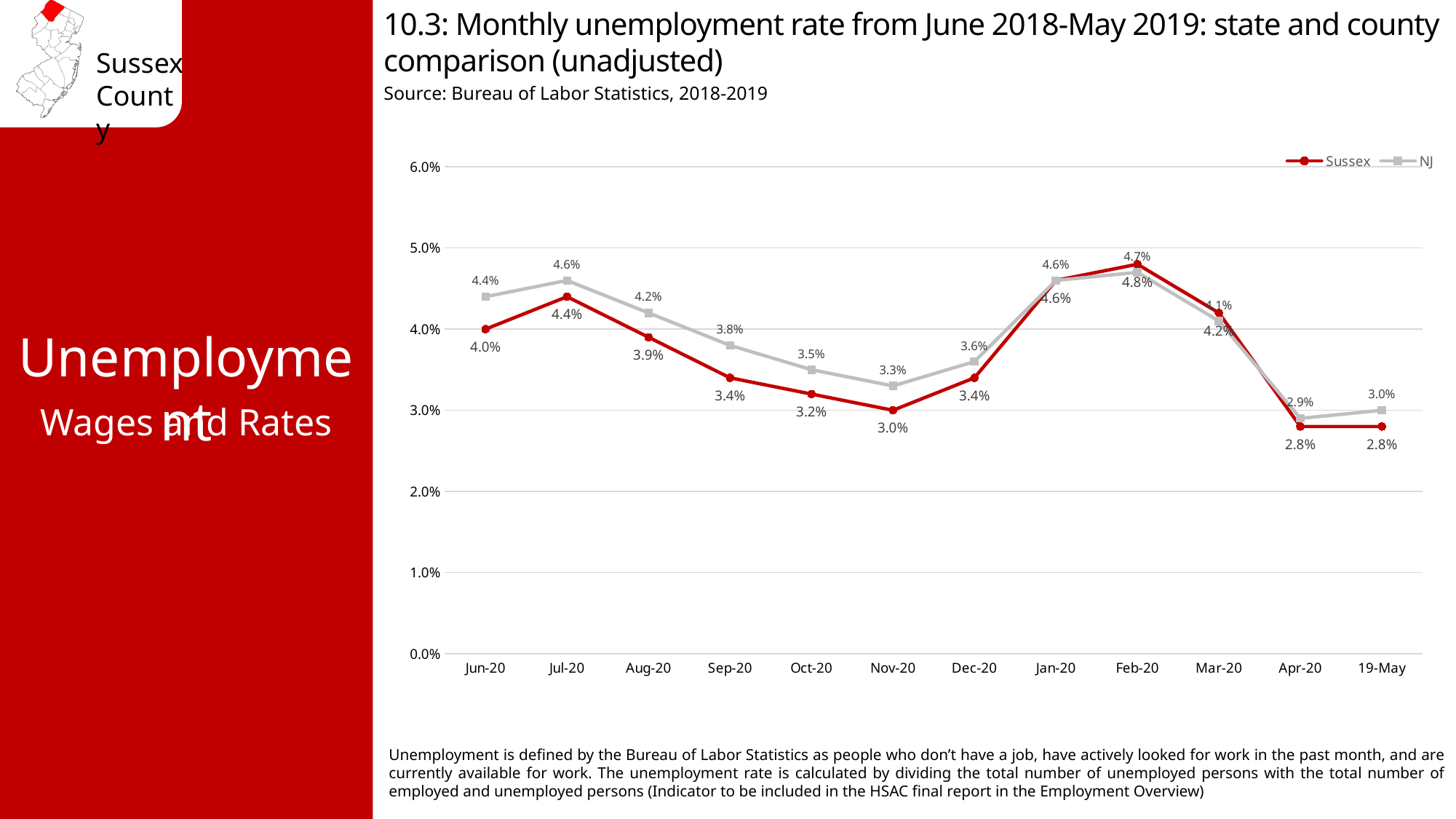
How many series does the legend list? 2 Which series has the higher value in Oct-20, Sussex or NJ? NJ Does the Sussex series rise or fall from Jul-20 to Nov-20? Fall How many months are plotted on the x axis? 12 What is the Sussex unemployment rate for Feb-20? 4.8% What kind of chart is shown on the slide? Line chart What is the difference between the NJ and Sussex rates in Sep-20? 0.4% In which month does the Sussex series reach its highest value? Feb-20 What is the NJ unemployment rate for Jul-20? 4.6% Which colour is used for the Sussex series? Red What is the Sussex unemployment rate for Nov-20? 3.0% In which month does the NJ series reach its lowest value? Apr-20